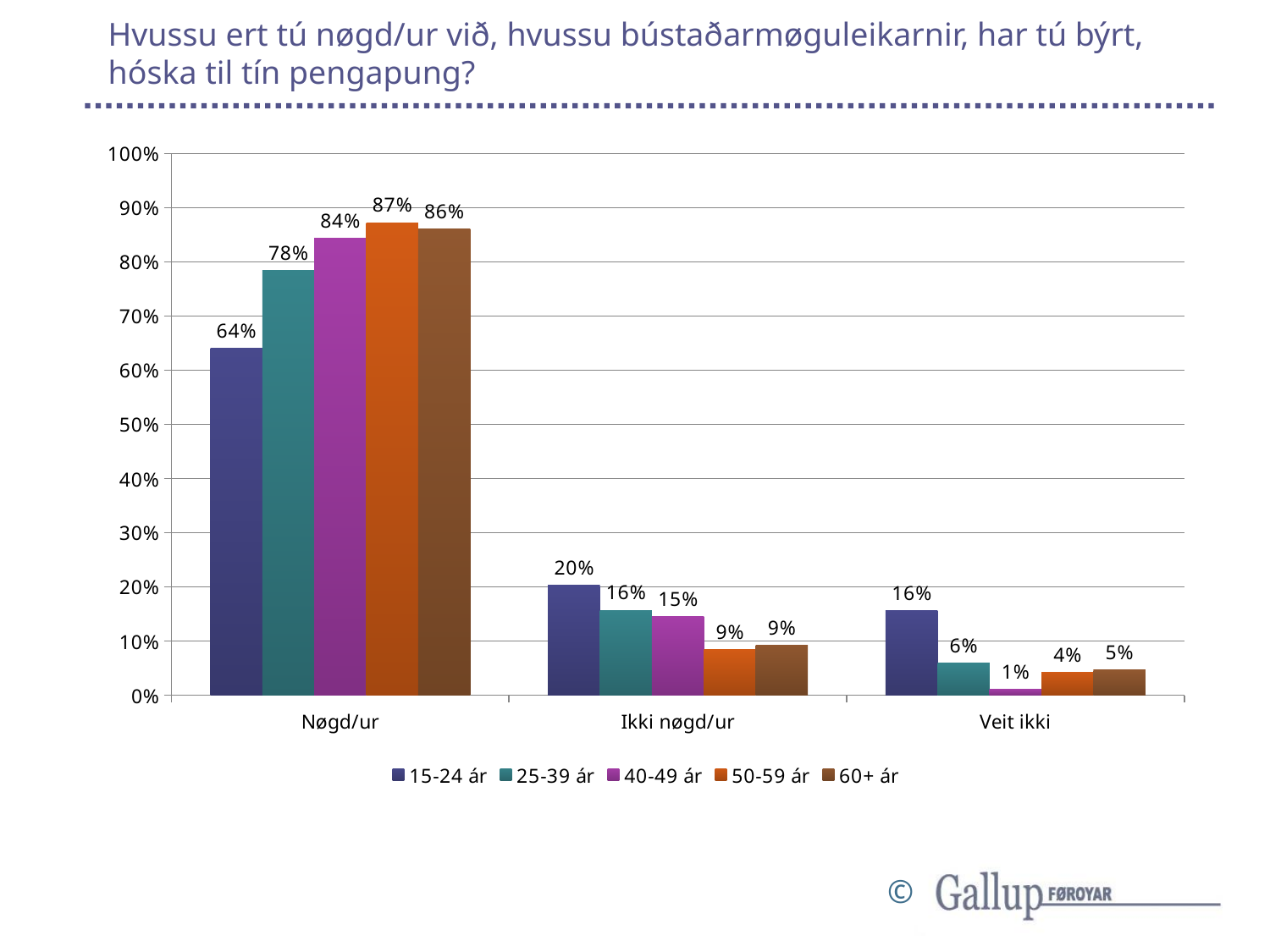
Is the value for 25-39 ár in the Nøgd/ur category greater or less than 70%? greater Which age group is shown in orange in the legend? 50-59 ár Which age group has the highest value in the Nøgd/ur category? 50-59 ár How many categories are shown on the x axis? 3 What is the value for the 15-24 ár series in the Nøgd/ur category? 64% How many series does the legend list? 5 What is the difference between the 50-59 ár and 15-24 ár values in the Nøgd/ur category? 23 percentage points In the Ikki nøgd/ur category, which is larger: the value for 15-24 ár or the value for 25-39 ár? 15-24 ár What is the value for the 50-59 ár series in the Ikki nøgd/ur category? 9% What is the value for the 40-49 ár series in the Veit ikki category? 1% Which age group has the lowest value in the Nøgd/ur category? 15-24 ár What kind of chart is shown on the slide? Bar chart